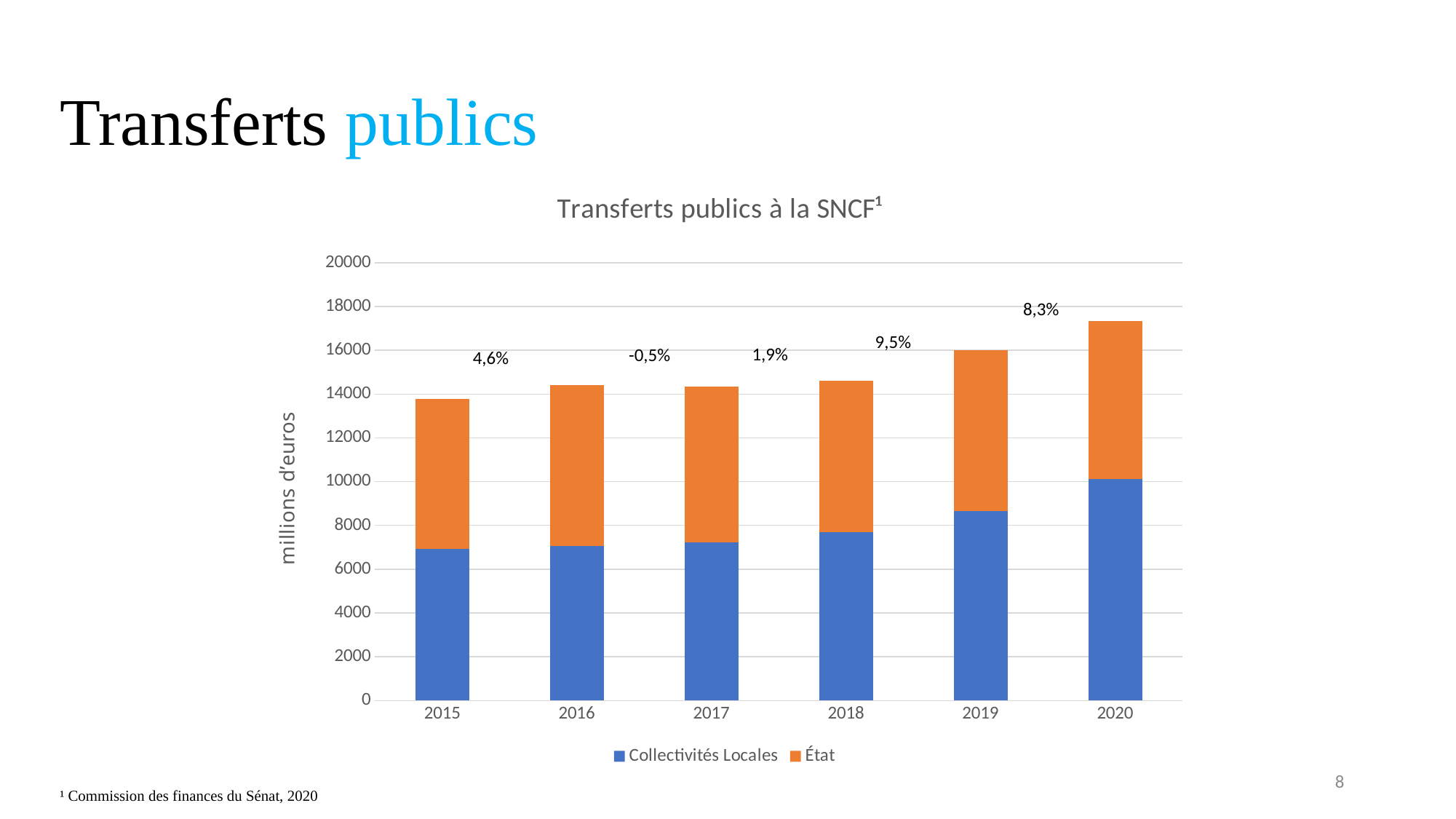
Is the total bar for 2015 greater or less than 14000? less Which year has the larger total bar, 2018 or 2019? 2019 Is the Collectivités Locales value for 2019 greater or less than 8000? greater Is the total bar for 2020 greater or less than 16000? greater What kind of chart is shown on the slide? Stacked bar chart Which year has the lowest total transfers in the chart? 2015 Which series is shown in orange in the chart? État What is the label on the vertical axis of the chart? millions d'euros How many years are shown on the x axis of the chart? 6 Which year has the highest total transfers in the chart? 2020 How many series does the chart legend list? 2